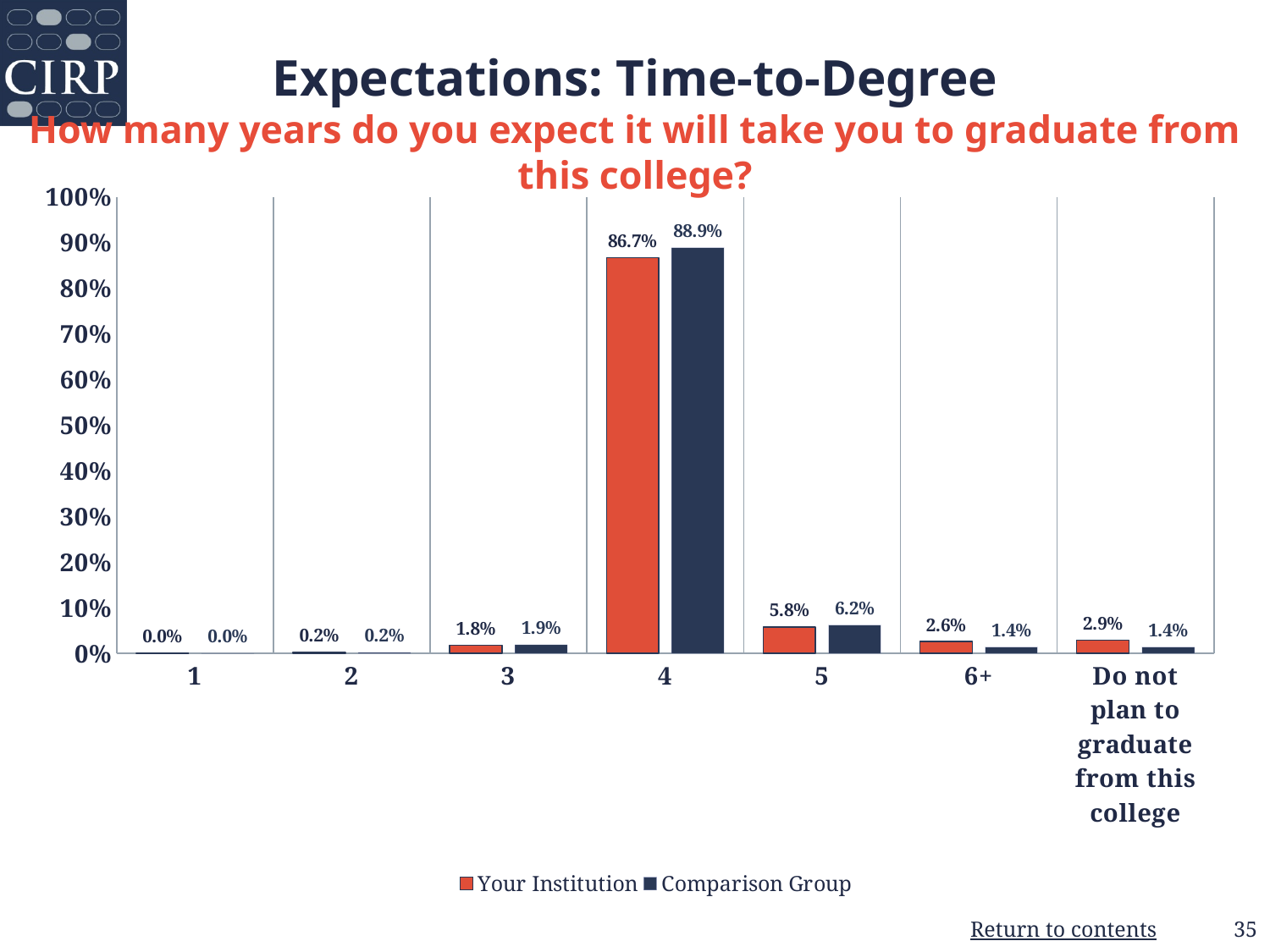
Is the value for Your Institution in the 4 category greater or less than 80%? greater What is the value for Your Institution in the 4 category? 86.7% What is the difference between Comparison Group and Your Institution in the 4 category? 2.2% What kind of chart is shown on the slide? bar chart Which category has the highest value for Comparison Group? 4 Which is larger in the 6+ category: Your Institution or Comparison Group? Your Institution What is the value for Your Institution in the 'Do not plan to graduate from this college' category? 2.9% How many series does the legend list? 2 How many categories are shown on the x axis? 7 What is the difference between Your Institution and Comparison Group in the 6+ category? 1.2% What is the value for Comparison Group in the 5 category? 6.2% What colour represents Comparison Group in the legend? dark navy blue